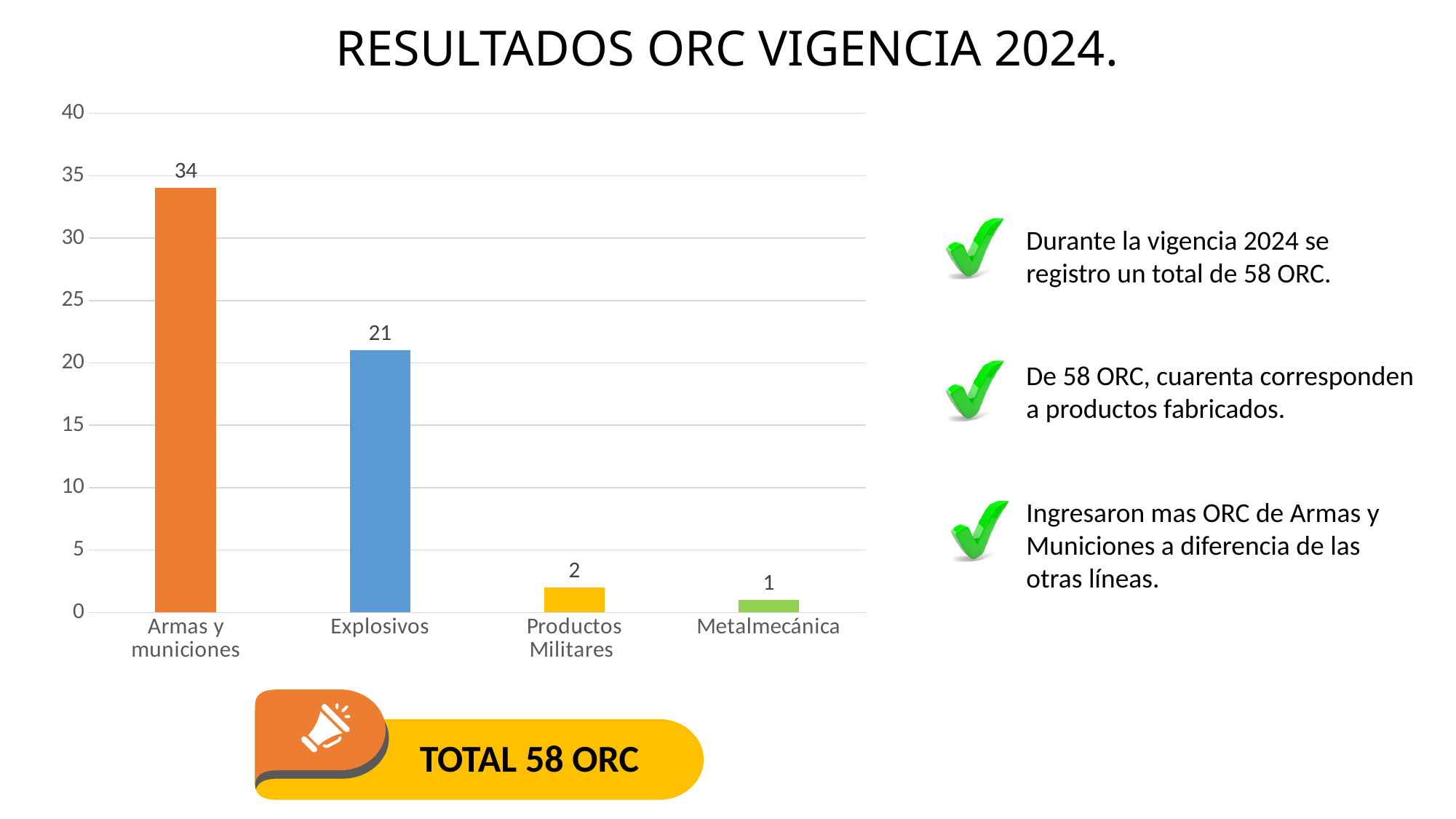
What is the value for Explosivos? 21 Which is larger, the value for Explosivos or the value for Productos Militares? Explosivos What is the value for Metalmecánica? 1 How many categories are shown on the chart? 4 Which category has the highest value? Armas y municiones What is the difference between the values for Armas y municiones and Explosivos? 13 Which category has the lowest value? Metalmecánica Is the value for Explosivos greater or less than 25? less What kind of chart is shown on the slide? bar chart What colour is the bar for Explosivos? blue What is the value for Productos Militares? 2 What is the value for Armas y municiones? 34